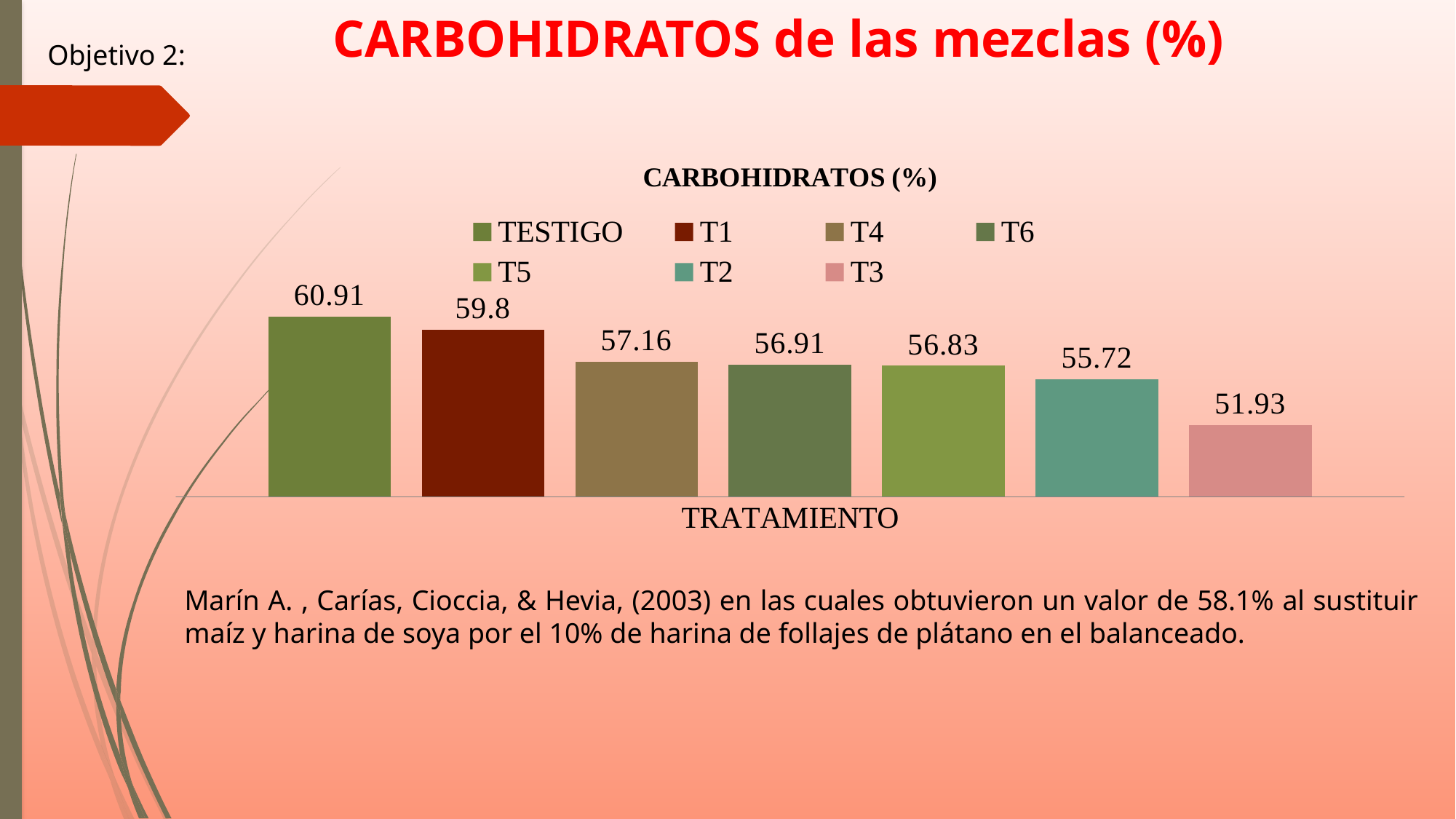
What is the difference between the carbohydrate values of TESTIGO and T3? 8.98 What is the carbohydrate value for T3? 51.93 Which treatment has the highest carbohydrate value? TESTIGO How many entries does the chart legend list? 7 Which treatment has the lowest carbohydrate value? T3 What type of chart is shown on the slide? bar chart What is the title of the chart? CARBOHIDRATOS (%) What is the carbohydrate value for T1? 59.8 How many bars are plotted in the chart? 7 Which has a larger carbohydrate value, T4 or T2? T4 What is the carbohydrate value for TESTIGO? 60.91 What is the carbohydrate value for T2? 55.72